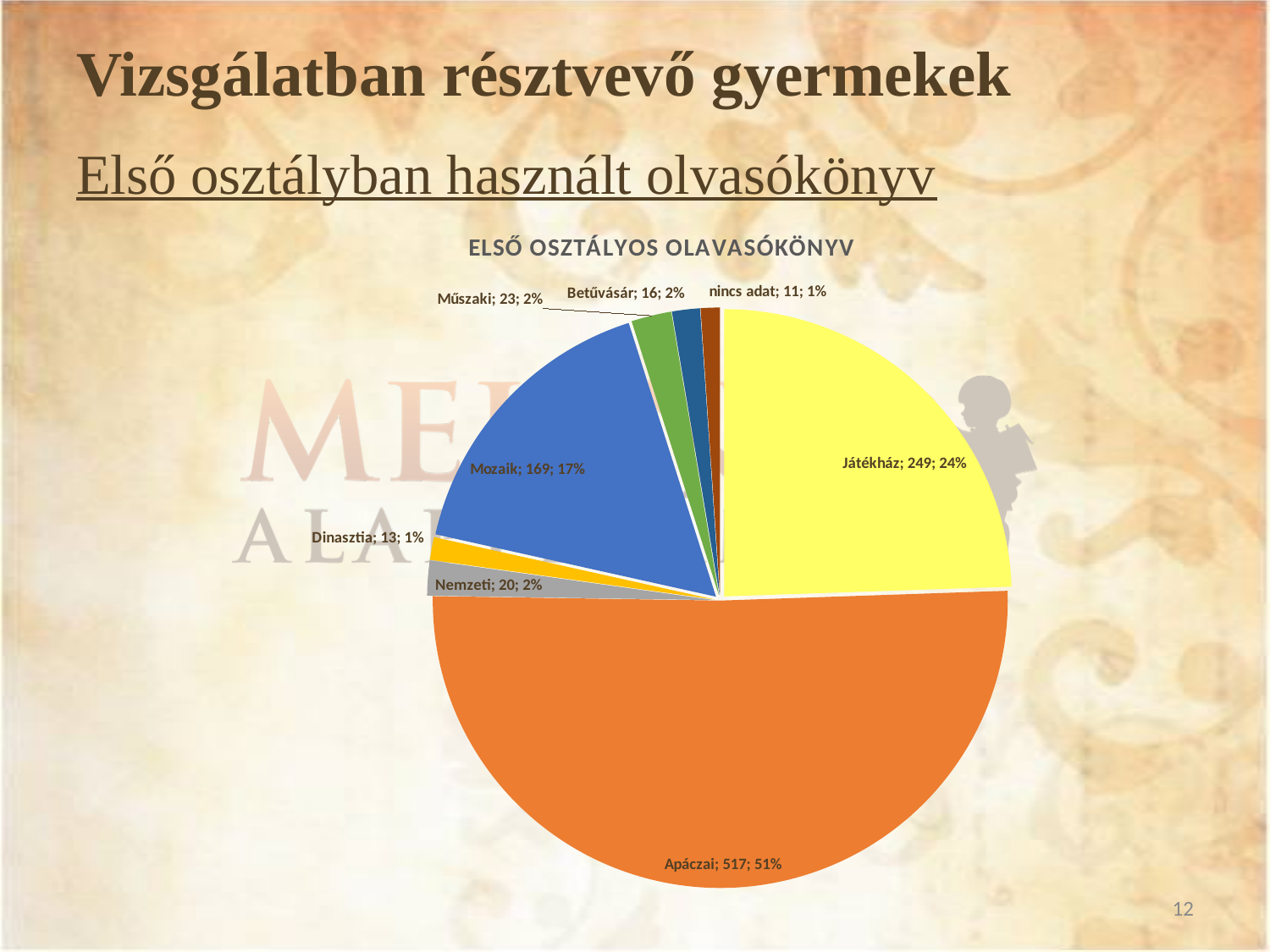
What is the value for Betűvásár? 16 How many slices does the pie chart have? 8 Which category has the smallest slice? nincs adat What is the value for Apáczai? 517 What kind of chart is shown on the slide? pie chart Which is larger, the value for Műszaki or the value for Nemzeti? Műszaki What is the difference between the values for Apáczai and Játékház? 268 What share of the pie does Mozaik represent? 17% Which category has the largest slice? Apáczai What share of the pie does Játékház represent? 24% What is the chart's title? ELSŐ OSZTÁLYOS OLAVASÓKÖNYV What is the value for Mozaik? 169